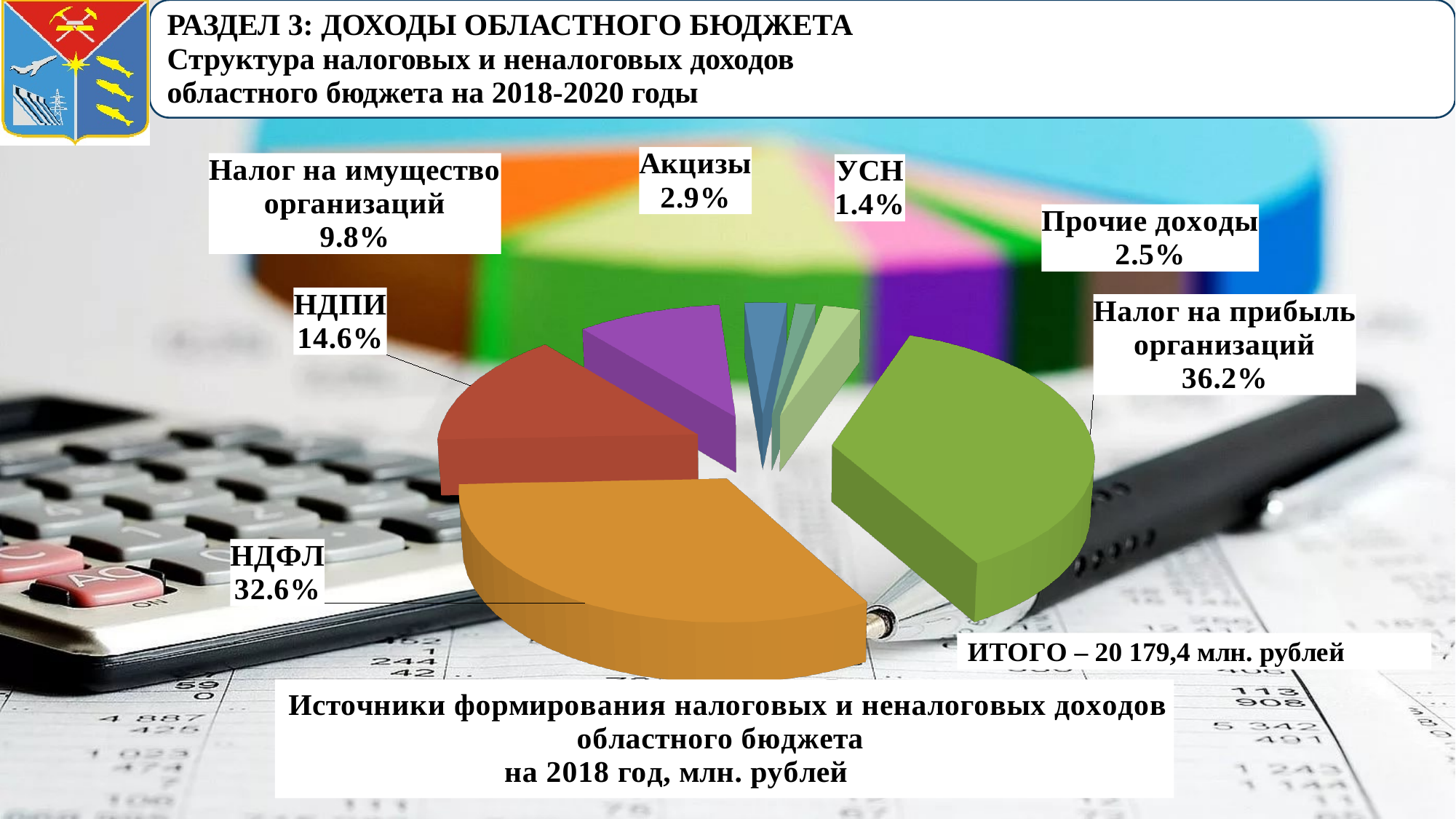
What share of the pie does Налог на прибыль организаций hold? 36.2% How many slices does the pie chart have? 7 What percentage is shown for Акцизы? 2.9% What percentage is shown for НДПИ? 14.6% Which category has the largest share of the pie? Налог на прибыль организаций What is the difference in percentage points between Налог на прибыль организаций and НДФЛ? 3.6 What kind of chart is shown on the slide? Pie chart Which category has the smallest share of the pie? УСН Which is larger: the share for НДПИ or the share for Налог на имущество организаций? НДПИ What total amount (ИТОГО) is stated on the slide? 20 179,4 млн. рублей What share of the pie does НДФЛ hold? 32.6% What is the difference in percentage points between Прочие доходы and УСН? 1.1